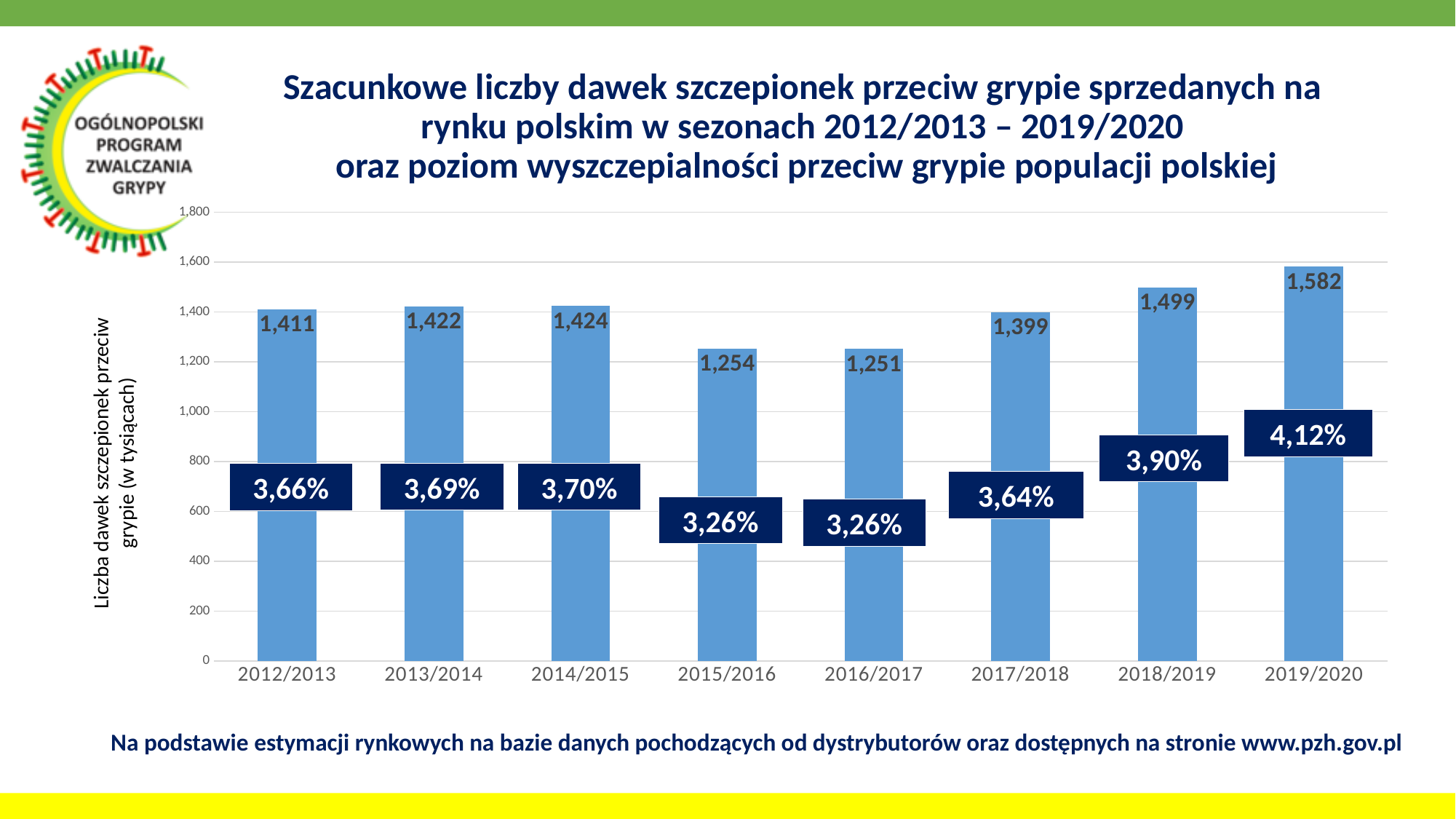
What is the difference in doses (in thousands) between the 2019/2020 and 2018/2019 seasons? 83 Which season has the highest number of doses sold? 2019/2020 Do the doses sold rise or fall from 2016/2017 to 2019/2020? rise What kind of chart is shown on the slide? bar chart Which season has the lowest number of doses sold? 2016/2017 Is the value for 2016/2017 greater or less than 1,400? less How many seasons are shown on the x axis? 8 What vaccination coverage percentage is shown for the 2015/2016 season? 3,26% How many doses (in thousands) were sold in the 2017/2018 season? 1,399 How many doses (in thousands) were sold in the 2019/2020 season? 1,582 Which season had more doses sold, 2012/2013 or 2015/2016? 2012/2013 What is the label of the vertical axis? Liczba dawek szczepionek przeciw grypie (w tysiącach)